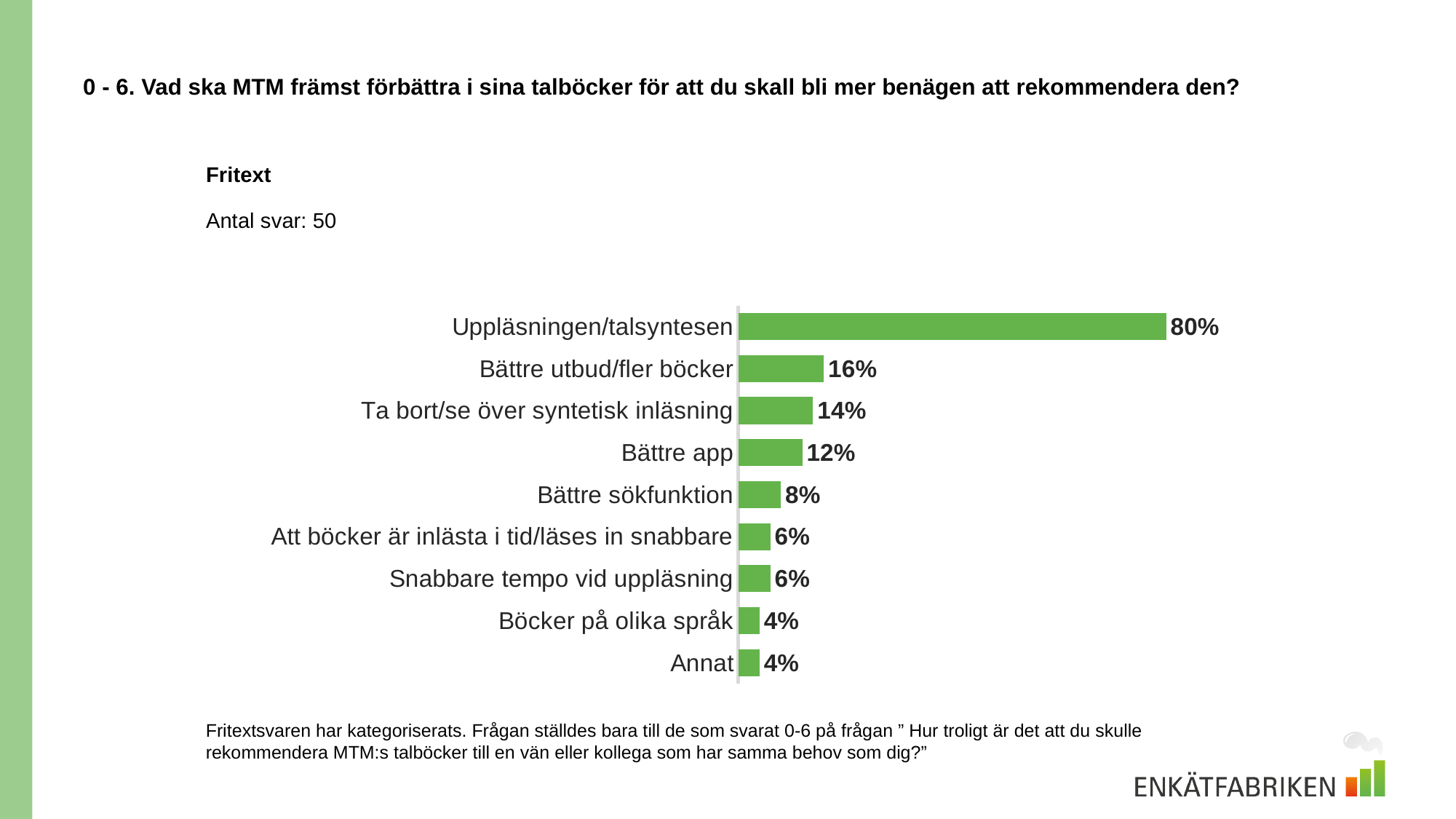
What is the value for Böcker på olika språk? 4% What is the value for Uppläsningen/talsyntesen? 80% Which is larger, Bättre utbud/fler böcker or Ta bort/se över syntetisk inläsning? Bättre utbud/fler böcker How many categories are shown in the chart? 9 What is the difference between Ta bort/se över syntetisk inläsning and Bättre app? 2% How many responses (Antal svar) does the slide report? 50 What is the value for Bättre sökfunktion? 8% What is the value for Bättre app? 12% Which is larger, Bättre sökfunktion or Snabbare tempo vid uppläsning? Bättre sökfunktion What kind of chart is shown on the slide? Bar chart Which category has the highest value? Uppläsningen/talsyntesen What is the difference between Uppläsningen/talsyntesen and Bättre utbud/fler böcker? 64%